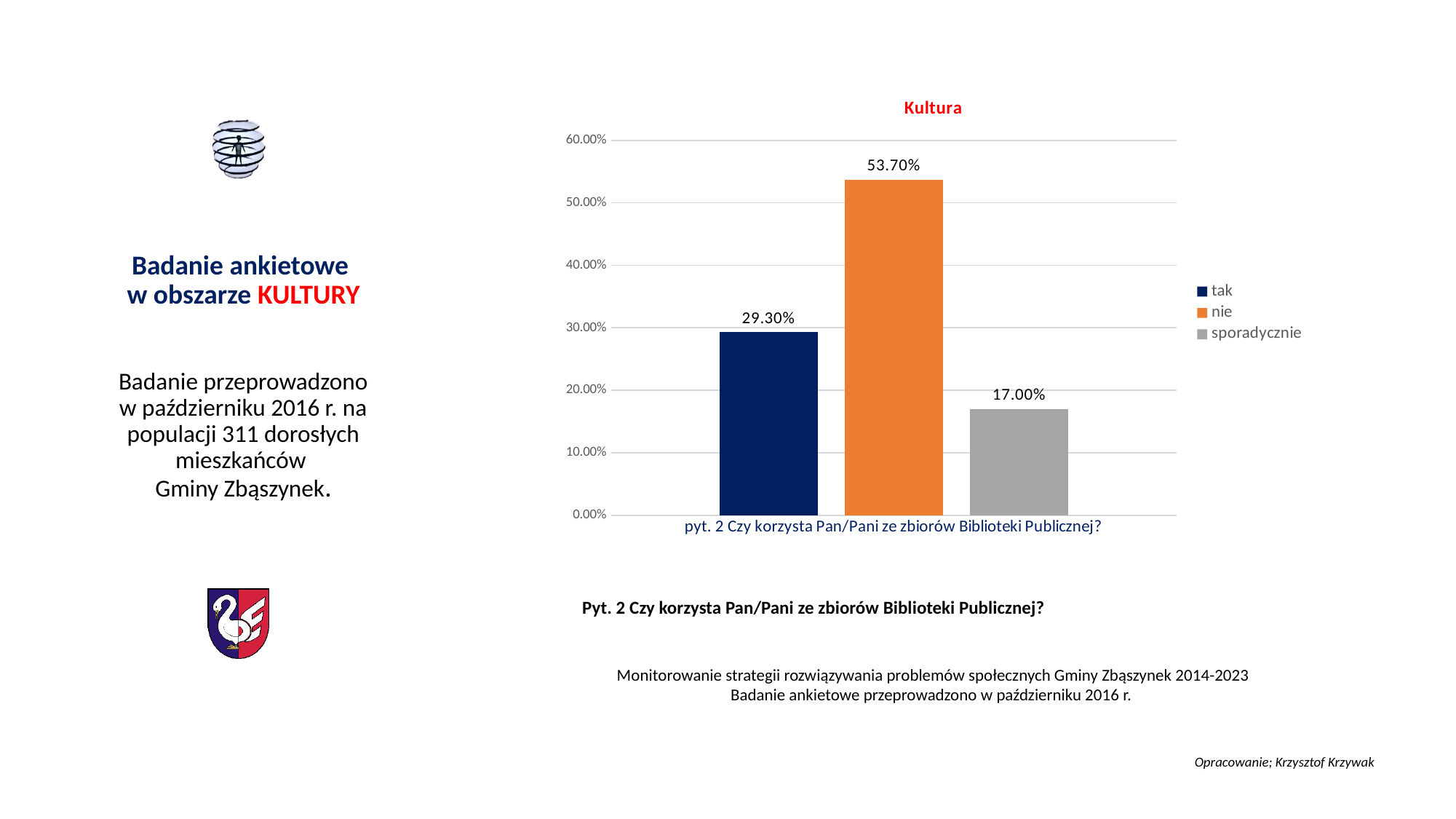
What is the value for "nie" in the chart? 53.70% Is the value for "nie" greater or less than 50.00%? greater What is the difference between the values for "nie" and "tak"? 24.40% What is the title of the chart? Kultura How many series does the legend list? 3 What is the difference between the values for "tak" and "sporadycznie"? 12.30% Which series has the highest value in the chart? nie What is the value for "tak" in the chart? 29.30% Which series has the lowest value in the chart? sporadycznie What is the value for "sporadycznie" in the chart? 17.00% Which is larger, the value for "tak" or the value for "sporadycznie"? tak What kind of chart is shown on the slide? bar chart